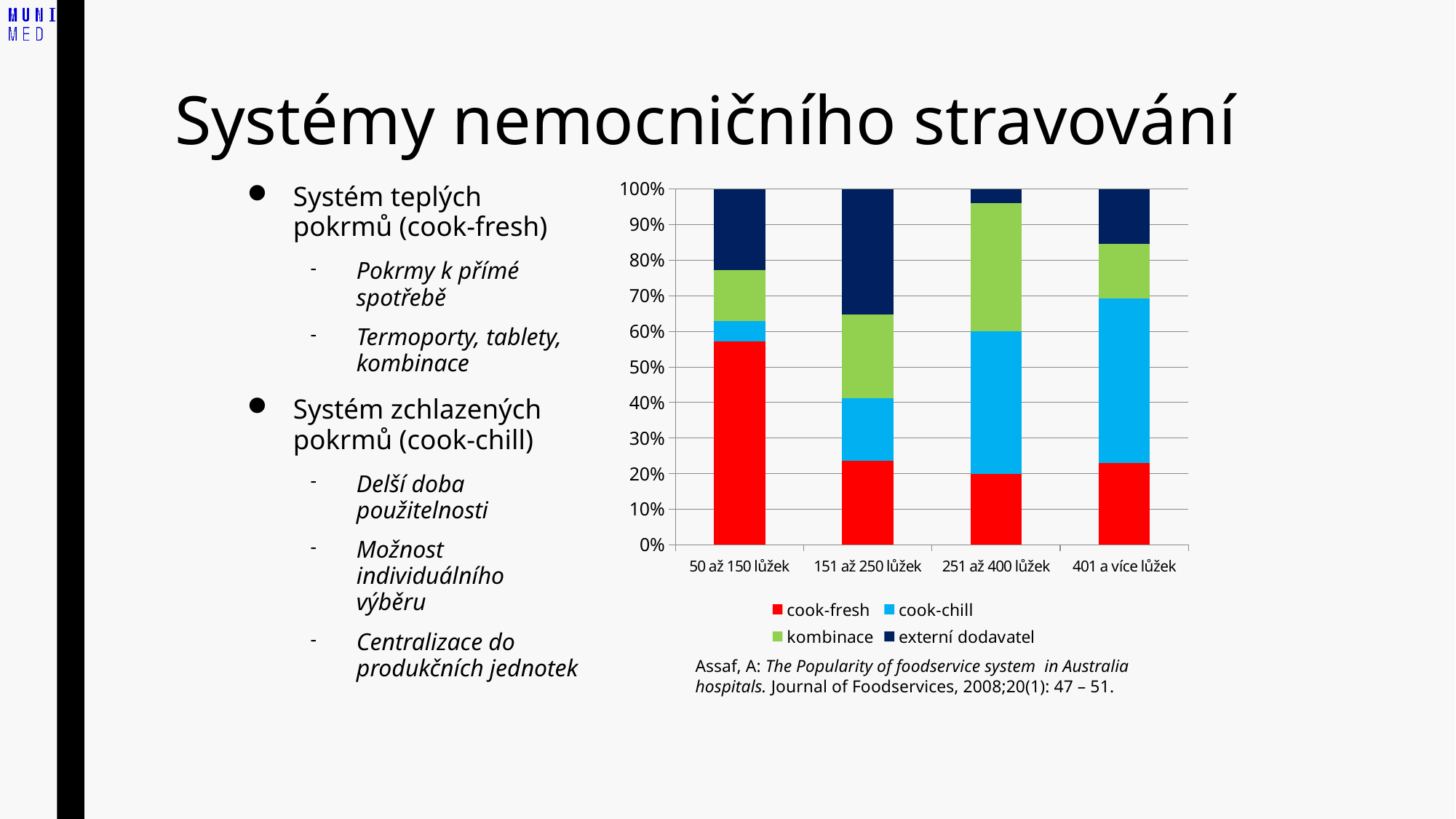
Is the cook-chill share for 50 až 150 lůžek greater or less than 10%? less How many hospital size categories are shown on the x axis? 4 Which hospital size category has the largest cook-fresh share? 50 až 150 lůžek Which hospital size category has the largest externí dodavatel share? 151 až 250 lůžek Which hospital size category has the smallest externí dodavatel share? 251 až 400 lůžek Which hospital size category has the largest kombinace share? 251 až 400 lůžek What kind of chart is shown on the slide? stacked bar chart How many series does the legend list? 4 Is the externí dodavatel share larger for 151 až 250 lůžek or for 401 a více lůžek? 151 až 250 lůžek Is the cook-fresh share for 251 až 400 lůžek greater or less than 30%? less What colour represents the cook-fresh series in the chart? red Is the cook-fresh share for 50 až 150 lůžek greater or less than 50%? greater